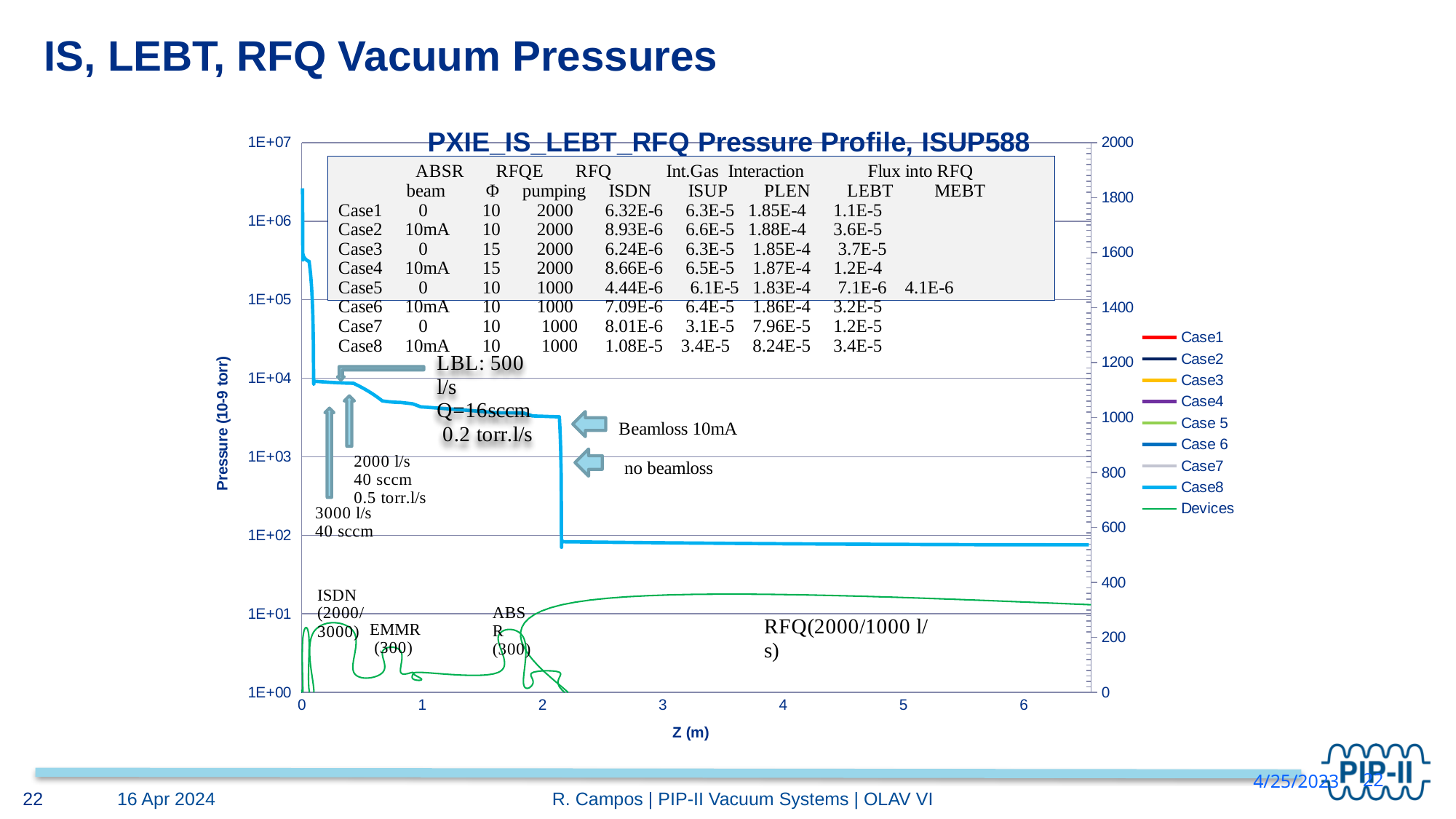
What is the label of the x axis? Z (m) What is the highest value labelled on the left-hand pressure axis? 1E+07 What is the title of the chart? PXIE_IS_LEBT_RFQ Pressure Profile, ISUP588 Does the Case8 pressure rise or fall as Z increases from 0 to 6 m? fall Is the Case8 pressure at Z = 1 m greater or less than 1E+03? greater Which is larger, the Case8 pressure at Z = 1 m or at Z = 5 m? Z = 1 m Is the Case8 pressure at Z = 4 m greater or less than 1E+03? less How many series does the chart legend list? 9 On the right-hand axis, is the Devices value at Z = 4 m greater or less than 400? less What type of chart is shown on the slide? line chart